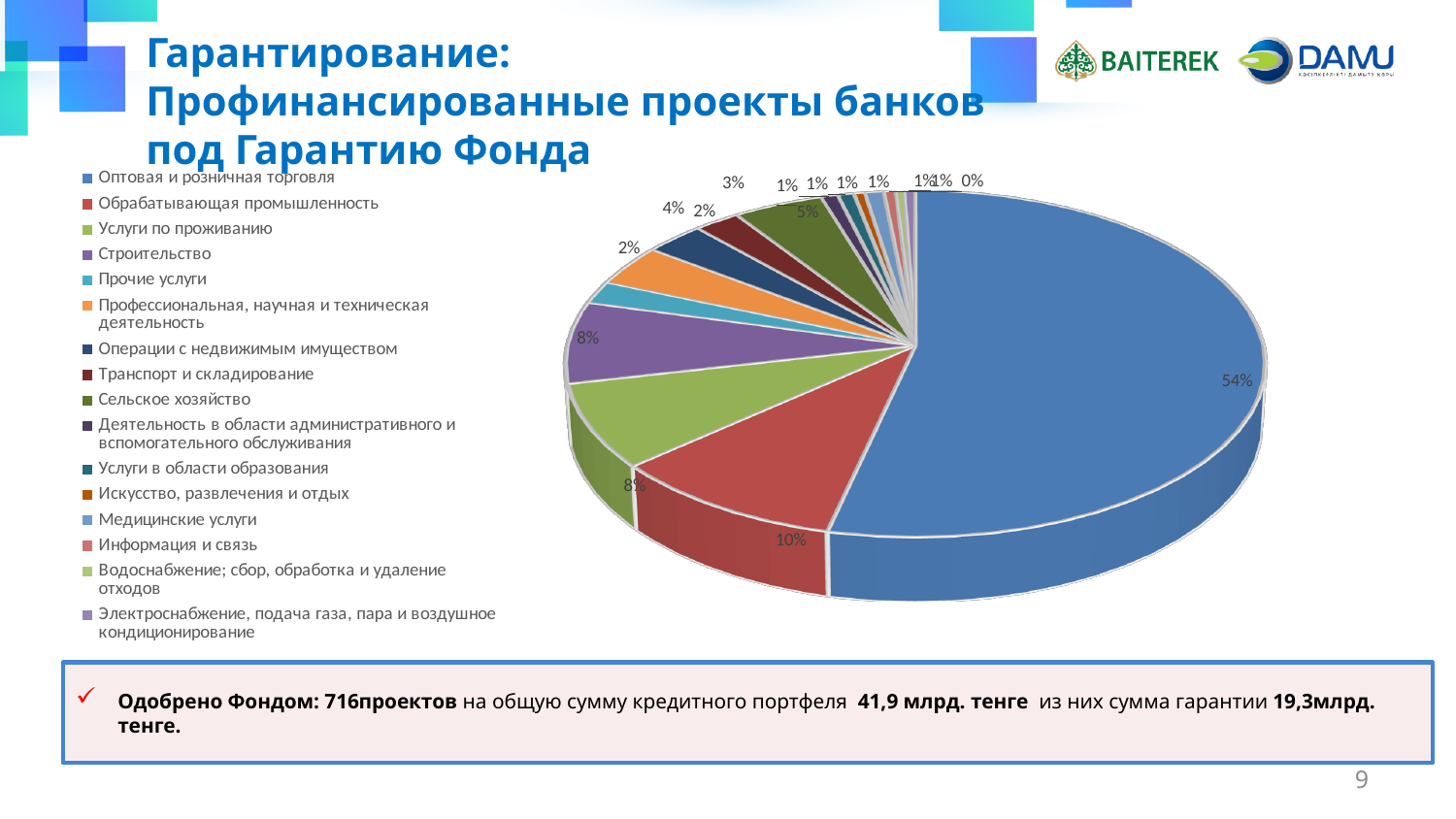
What kind of chart is shown on the slide? pie chart Which category has the largest share of the pie? Оптовая и розничная торговля What share of the pie does Сельское хозяйство have? 5% Which category has the smallest share of the pie? Водоснабжение; сбор, обработка и удаление отходов What share of the pie does Транспорт и складирование have? 2% What share of the pie does Профессиональная, научная и техническая деятельность have? 4% Which is larger, the share for Обрабатывающая промышленность or the share for Сельское хозяйство? Обрабатывающая промышленность How many categories does the legend list? 16 What share of the pie does Обрабатывающая промышленность have? 10% What is the difference in percentage points between the share for Оптовая и розничная торговля and the share for Обрабатывающая промышленность? 44 What share of the pie does Услуги по проживанию have? 8% What share of the pie does Оптовая и розничная торговля have? 54%